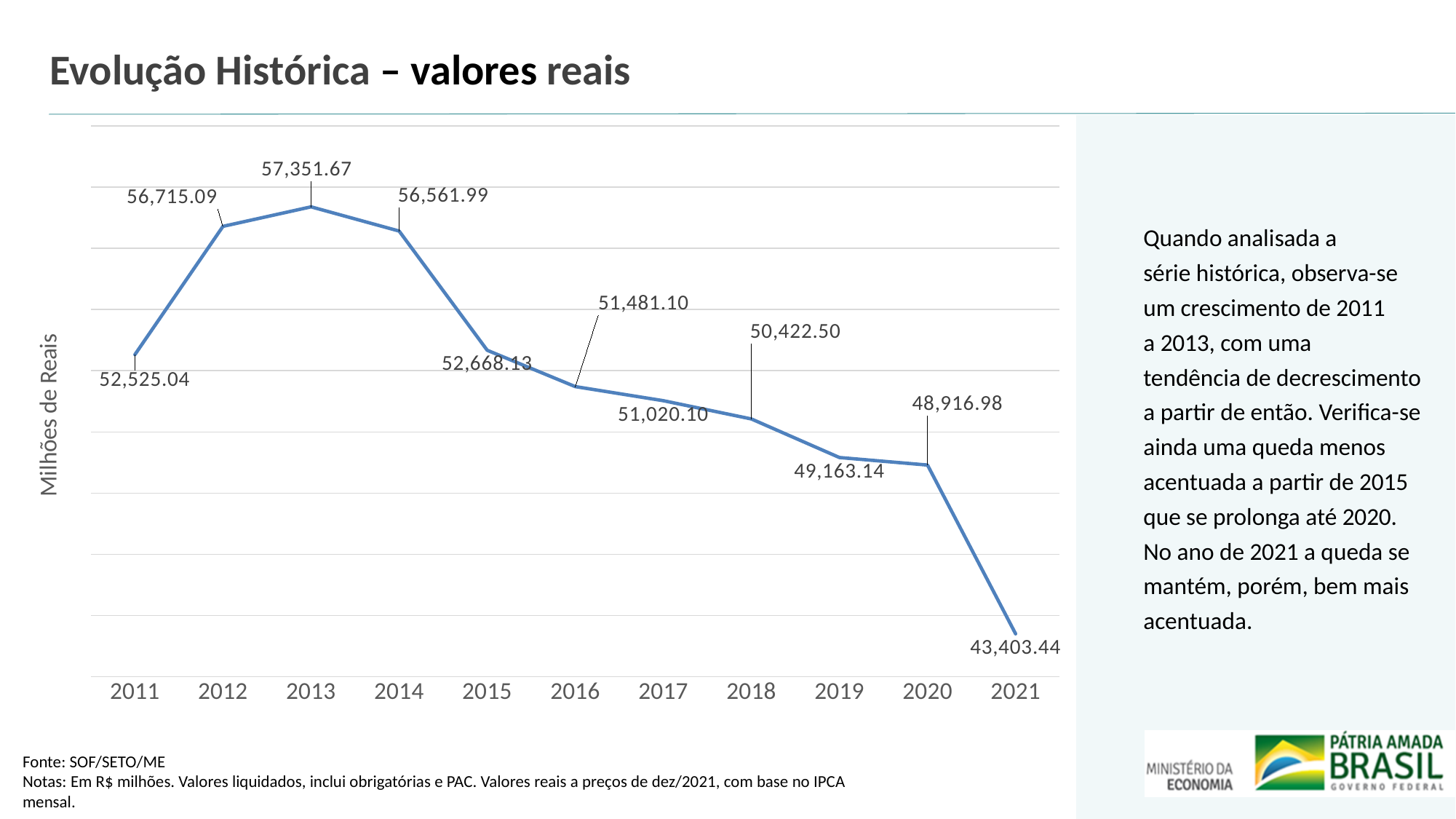
Which year has the highest value? 2013 How many years are plotted on the chart? 11 What is the value for 2021? 43,403.44 What kind of chart is shown? Line chart What is the value for 2011? 52,525.04 Do the values rise or fall from 2013 to 2021? Fall What is the value for 2018? 50,422.50 What is the difference between the values for 2020 and 2021? 5,513.54 Which year has the lowest value? 2021 What is the value for 2013? 57,351.67 What is the difference between the values for 2013 and 2011? 4,826.63 Which is larger, the value for 2012 or the value for 2014? 2012